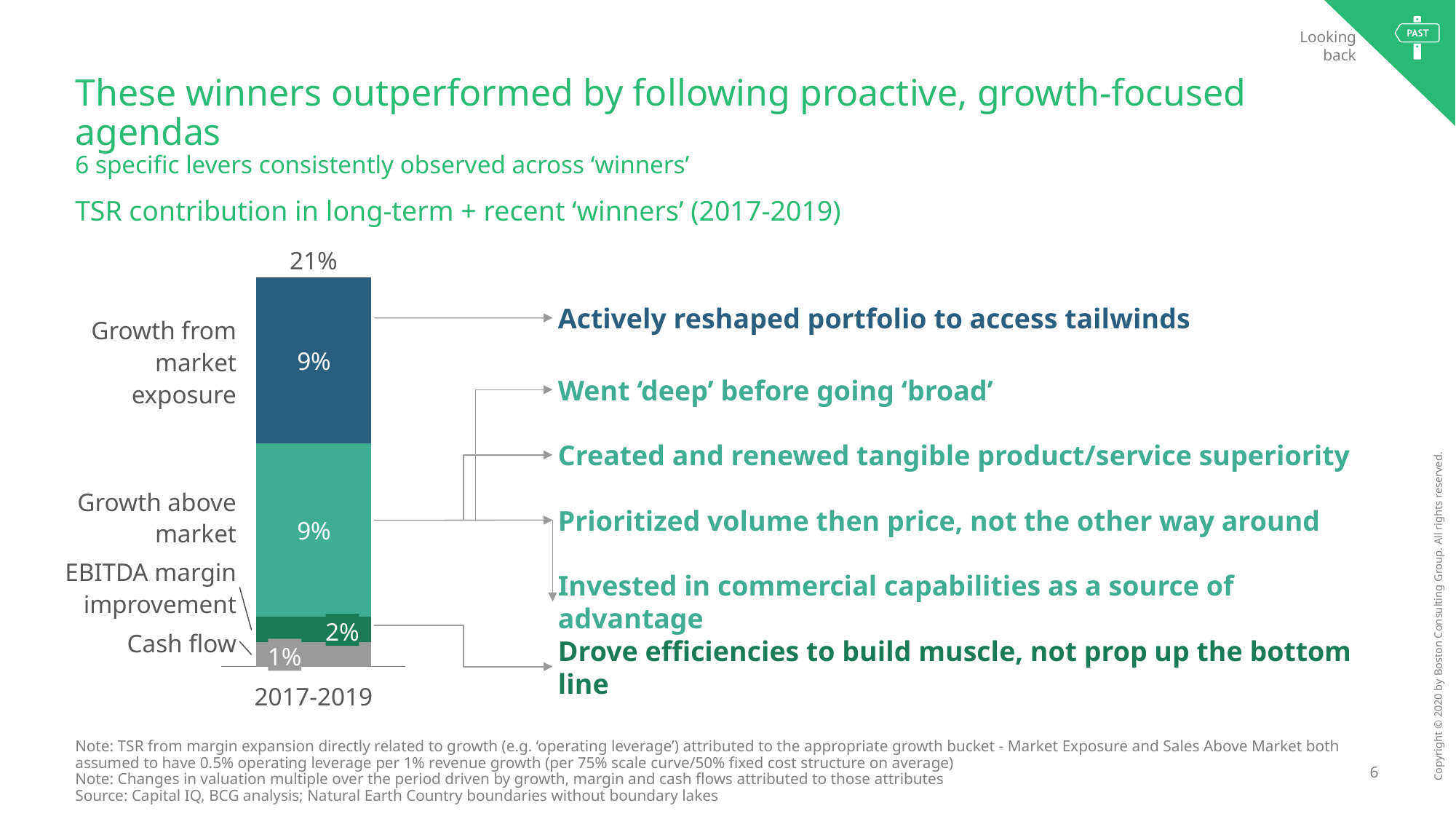
What is the title of the chart? TSR contribution in long-term + recent 'winners' (2017-2019) What is the difference between the 'EBITDA margin improvement' and 'Cash flow' contributions? 1% What is the TSR contribution from 'EBITDA margin improvement' for 2017-2019? 2% What is the total TSR contribution shown at the top of the 2017-2019 stacked bar? 21% What is the TSR contribution from 'Cash flow' for 2017-2019? 1% What is the difference between the 'Growth above market' and 'EBITDA margin improvement' contributions? 7% What is the TSR contribution from 'Growth above market' for 2017-2019? 9% What type of chart is shown on the slide? Stacked bar chart Which segment contributes the least to TSR in the 2017-2019 bar? Cash flow How many segments make up the 2017-2019 stacked bar? 4 What is the TSR contribution from 'Growth from market exposure' for 2017-2019? 9% Which is larger, the contribution from 'Growth above market' or from 'Cash flow'? Growth above market